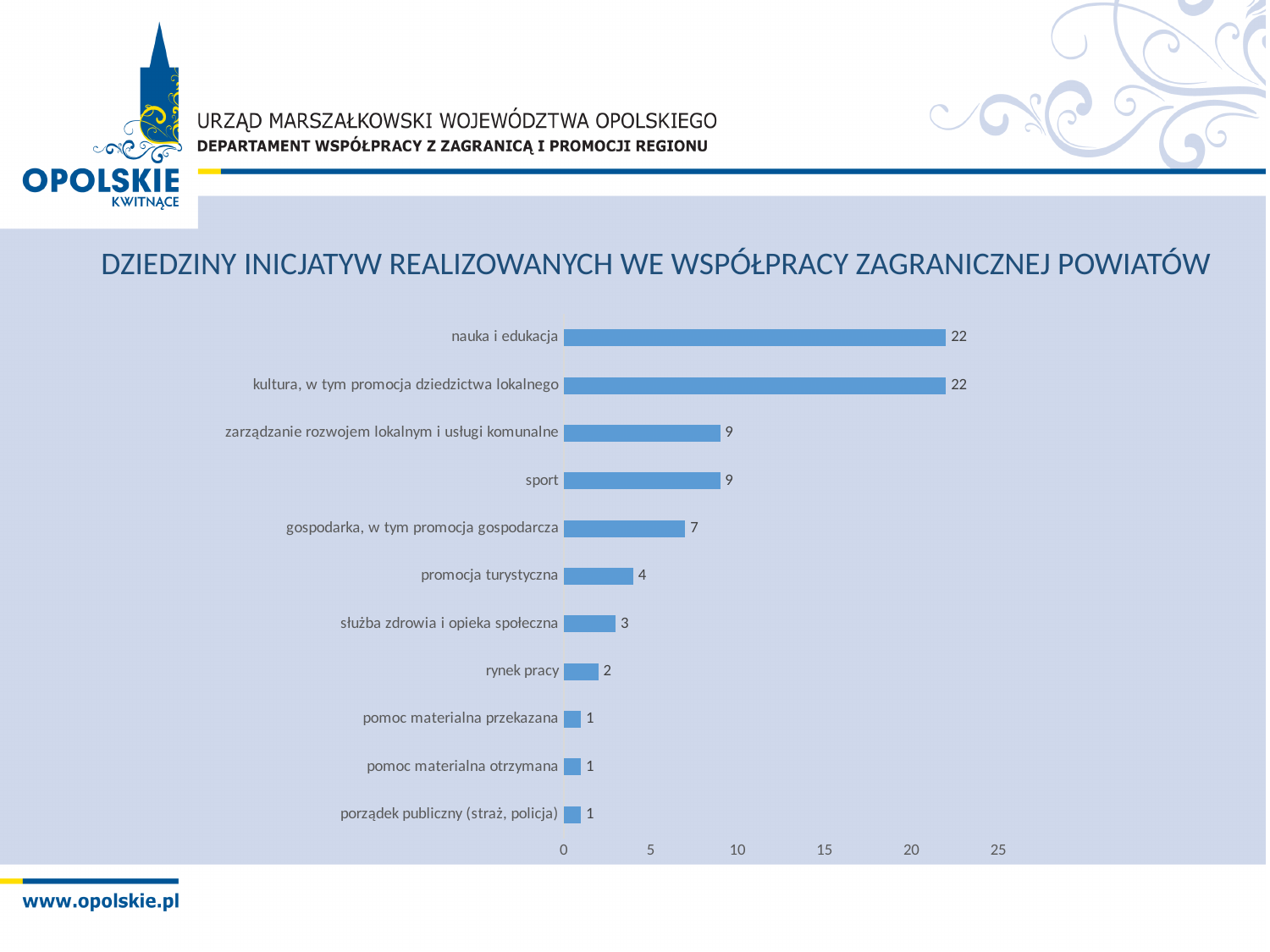
What is the value for "gospodarka, w tym promocja gospodarcza"? 7 What is the value for "promocja turystyczna"? 4 What kind of chart is shown on the slide? bar chart How many categories are shown in the chart? 11 What is the value for "sport"? 9 What is the difference between the values for "kultura, w tym promocja dziedzictwa lokalnego" and "sport"? 13 What is the difference between the values for "gospodarka, w tym promocja gospodarcza" and "promocja turystyczna"? 3 What is the value for "nauka i edukacja"? 22 Is the value for "nauka i edukacja" greater or less than 20? greater What is the value for "rynek pracy"? 2 Which has a larger value, "zarządzanie rozwojem lokalnym i usługi komunalne" or "rynek pracy"? zarządzanie rozwojem lokalnym i usługi komunalne What is the value for "służba zdrowia i opieka społeczna"? 3